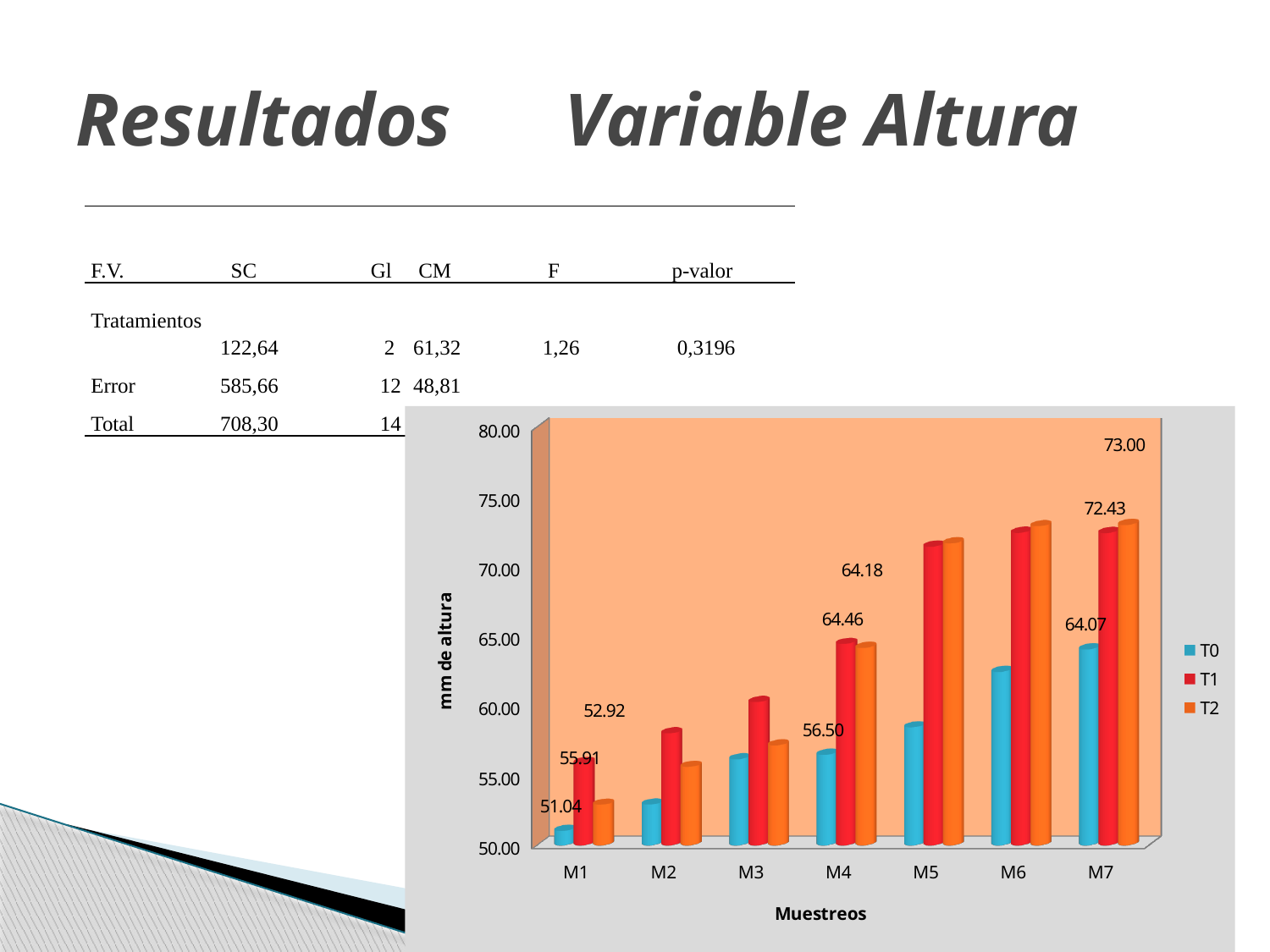
How many sampling categories (Muestreos) are shown on the x axis of the chart? 7 At M4, which is larger, T1 or T2? T1 Which category has the lowest T0 value? M1 What is the value of T2 at M7? 73.00 What kind of chart is shown on the slide? bar chart How many series does the chart legend list? 3 What is the value of T0 at M1? 51.04 What is the difference between T1 and T0 at M1? 4.87 What is the title of the vertical axis of the chart? mm de altura What is the value of T1 at M7? 72.43 Is the value for T0 at M6 greater or less than 60.00? greater Do the T0 values rise or fall from M1 to M7? rise